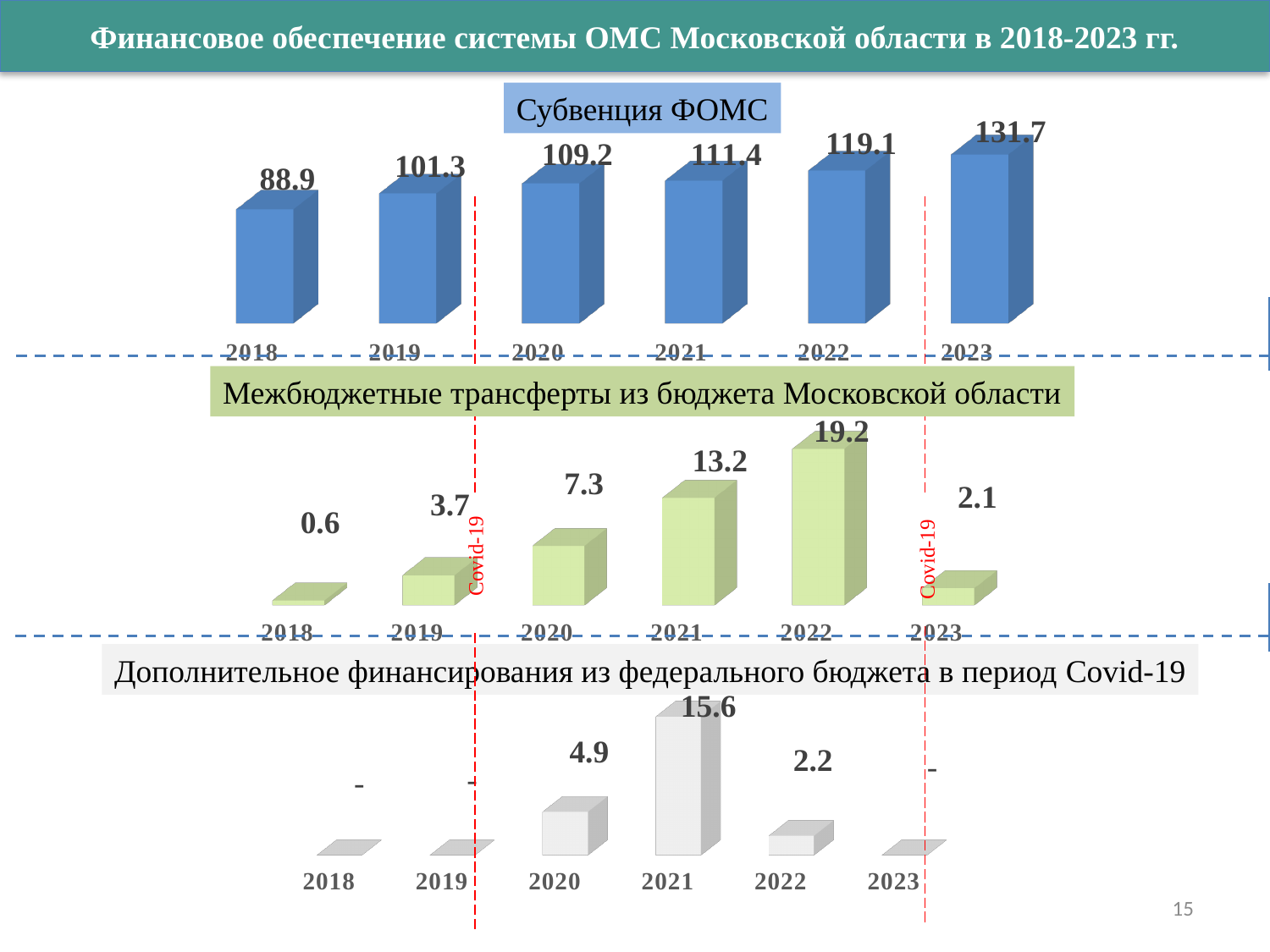
In the 'Субвенция ФОМС' chart, do the values rise or fall from 2018 to 2023? rise In the 'Субвенция ФОМС' chart, what is the difference between the 2023 and 2018 values? 42.8 In the 'Дополнительное финансирования из федерального бюджета в период Covid-19' chart, what is the difference between the 2021 and 2020 values? 10.7 In the 'Межбюджетные трансферты из бюджета Московской области' chart, which is larger, the value for 2020 or the value for 2023? 2020 In the 'Межбюджетные трансферты из бюджета Московской области' chart, which year has the lowest value? 2018 In the 'Субвенция ФОМС' chart, which year has the highest value? 2023 What type of chart is the 'Субвенция ФОМС' chart? bar chart In the 'Субвенция ФОМС' chart, how many years are plotted? 6 In the 'Межбюджетные трансферты из бюджета Московской области' chart, which year has the highest value? 2022 In the 'Дополнительное финансирования из федерального бюджета в период Covid-19' chart, what is the value for 2021? 15.6 In the 'Межбюджетные трансферты из бюджета Московской области' chart, what is the value for 2021? 13.2 In the 'Субвенция ФОМС' chart, what is the value for 2018? 88.9